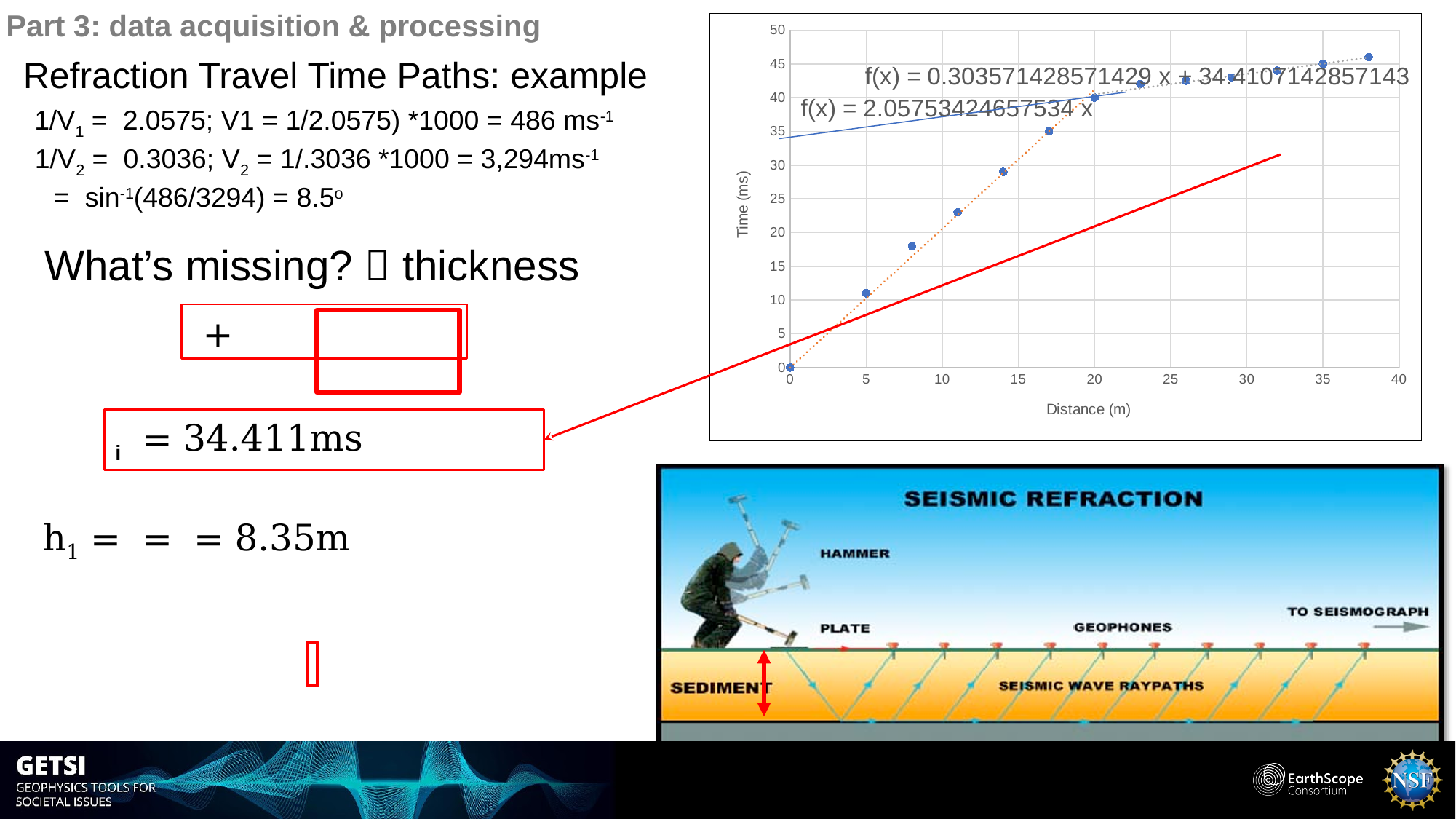
Do the plotted time values rise or fall as distance increases along the x axis? rise Is the time value at a distance of 11 m greater or less than 25? less At which distance is the plotted time value lowest? 0 Which has the larger time value: the point at 14 m or the point at 29 m? 29 m How many data points are plotted on the chart? 13 Is the time value at a distance of 26 m greater or less than 40? greater What is the label of the horizontal axis of the chart? Distance (m) What is the label of the vertical axis of the chart? Time (ms) Is the time value at a distance of 8 m greater or less than 15? greater What kind of chart is shown on the slide? scatter chart